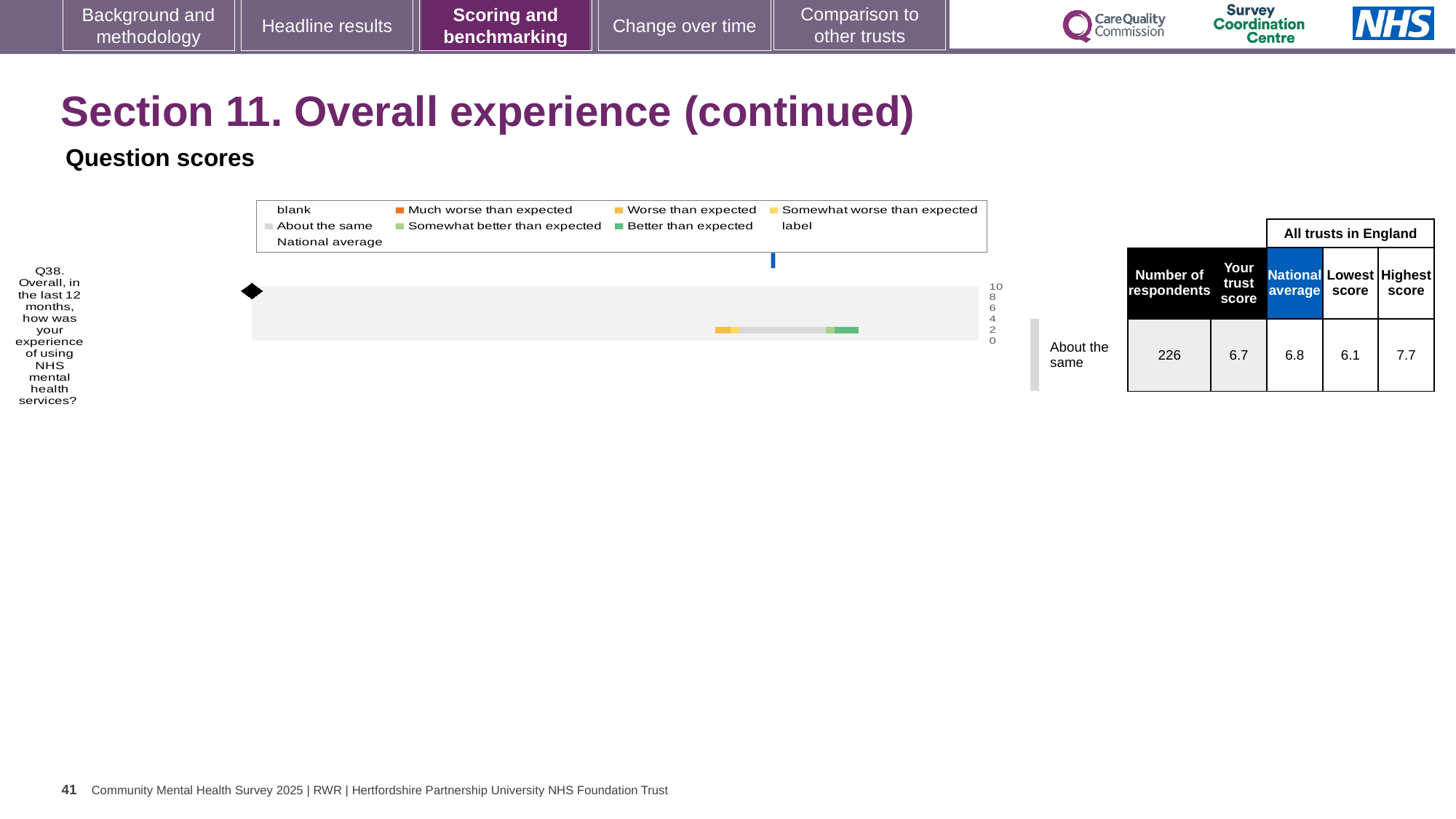
What is the highest score among all trusts in England for Q38? 7.7 In the chart legend, what colour represents "Better than expected"? green Is the trust's score for Q38 higher or lower than the national average? lower How many respondents answered Q38 according to the table beside the chart? 226 How many survey questions are plotted in the chart? 1 What is the trust's score for Q38 in the table beside the chart? 6.7 What benchmark category is shown for Q38 next to the chart? About the same What is the difference between the highest and lowest scores among all trusts in England for Q38? 1.6 What kind of chart is used to show the Q38 question score? bar chart What is the highest value shown on the chart's score axis? 10 What is the lowest score among all trusts in England for Q38? 6.1 What is the national average score for Q38 in the table beside the chart? 6.8